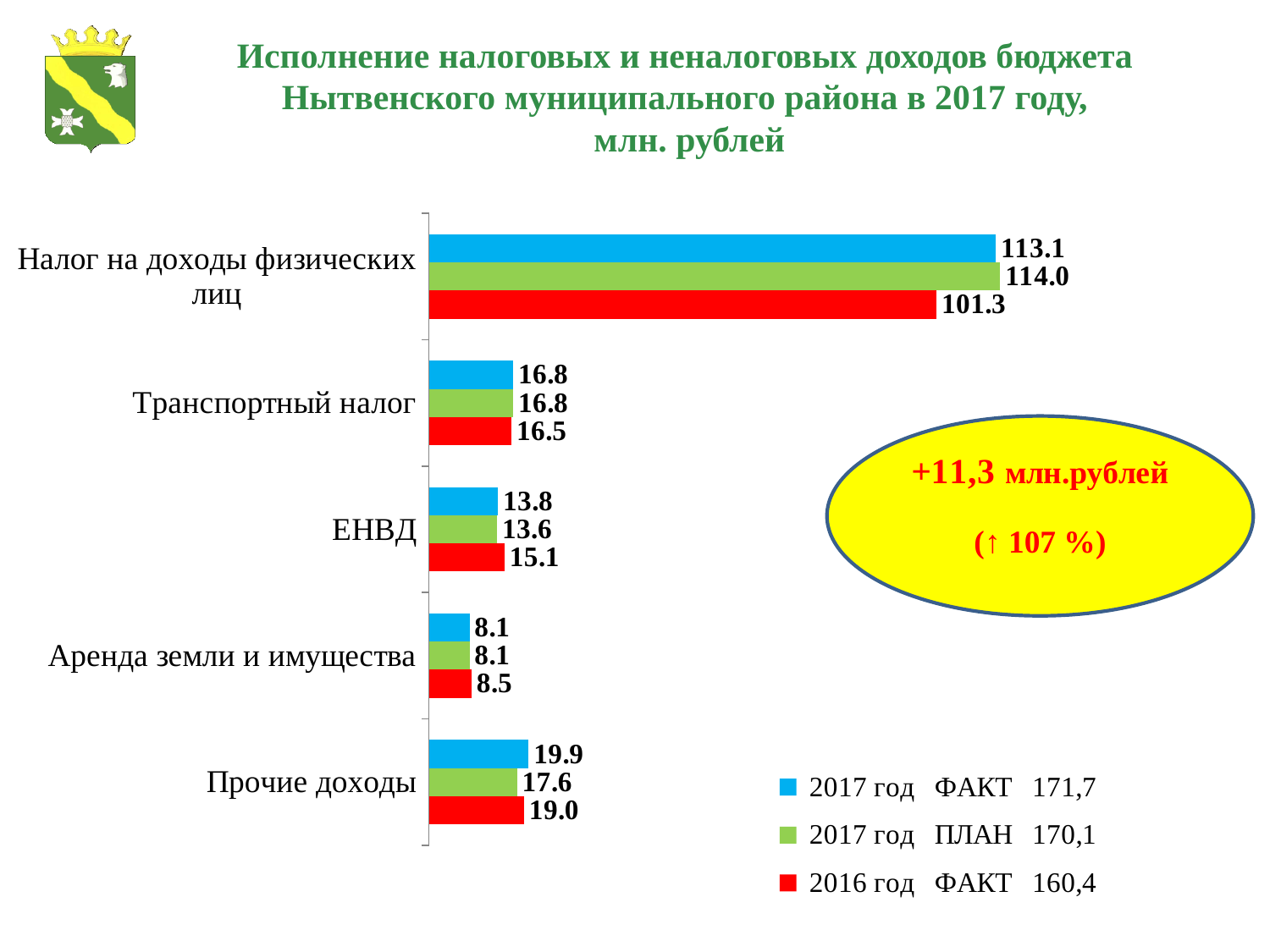
Which category has the lowest 2016 год ФАКТ value? Аренда земли и имущества For ЕНВД, which is larger: the 2017 год ФАКТ value or the 2016 год ФАКТ value? 2016 год ФАКТ What kind of chart is shown on the slide? Bar chart What is the difference between the 2017 год ФАКТ and 2017 год ПЛАН values for Прочие доходы? 2.3 What is the 2017 год ПЛАН value for Прочие доходы? 17.6 How many series does the legend list? 3 What colour are the 2016 год ФАКТ bars? Red What is the difference between the 2017 год ПЛАН and 2016 год ФАКТ values for Налог на доходы физических лиц? 12.7 Which category has the highest 2017 год ФАКТ value? Налог на доходы физических лиц What is the 2016 год ФАКТ value for ЕНВД? 15.1 How many categories are shown on the chart? 5 What is the 2017 год ФАКТ value for Налог на доходы физических лиц? 113.1